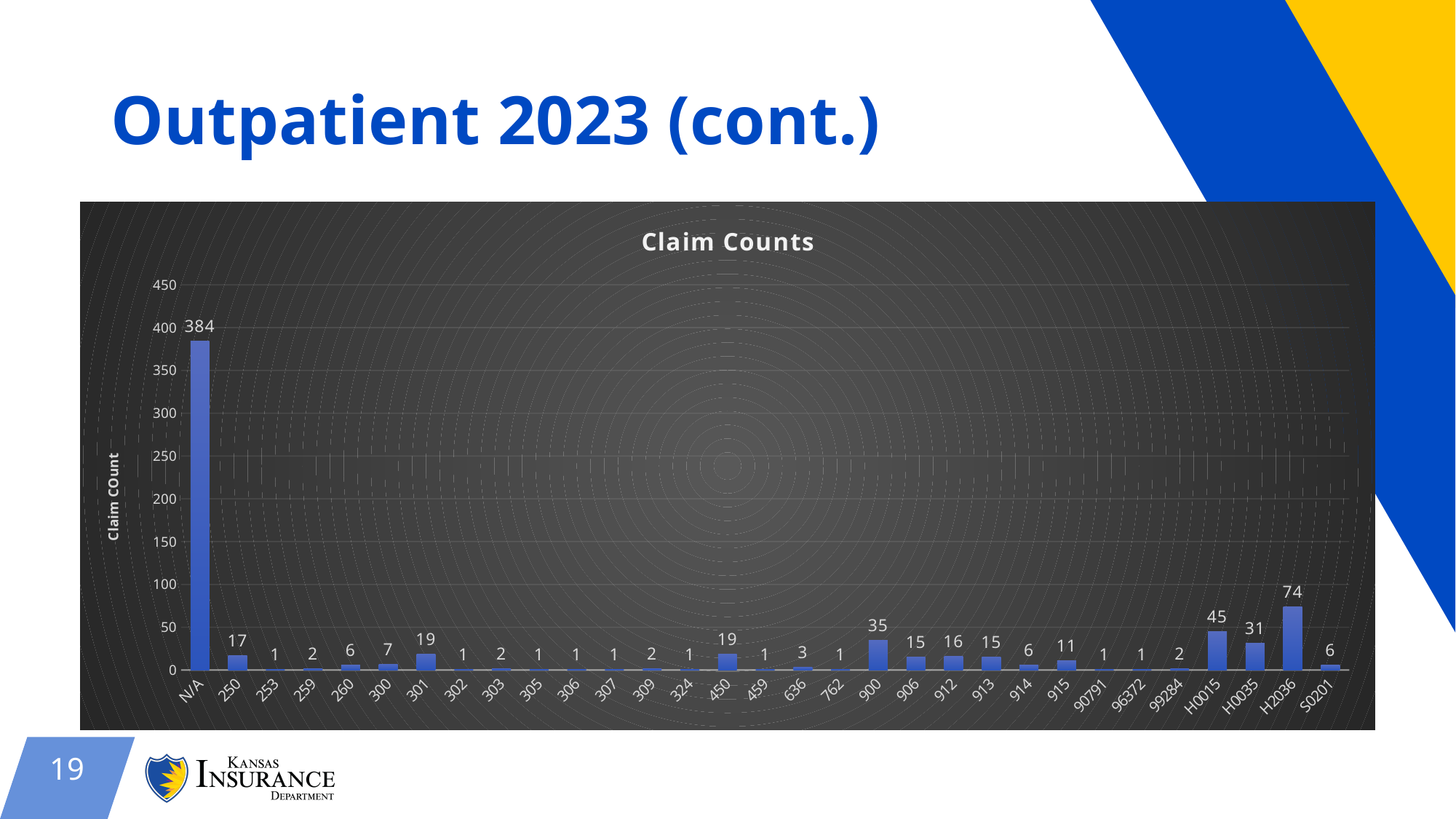
What is the difference in claim counts between H2036 and H0035? 43 Which category has the highest claim count? N/A What is the claim count for H0015? 45 Is the claim count for N/A greater or less than 350? greater What is the claim count for category 900? 35 What is the title of the chart? Claim Counts Which has a larger claim count, category 301 or category 250? 301 What is the claim count for H2036? 74 What is the claim count for category 915? 11 What kind of chart is shown on the slide? Bar chart How many categories are shown on the x axis? 31 What is the claim count for the N/A category? 384